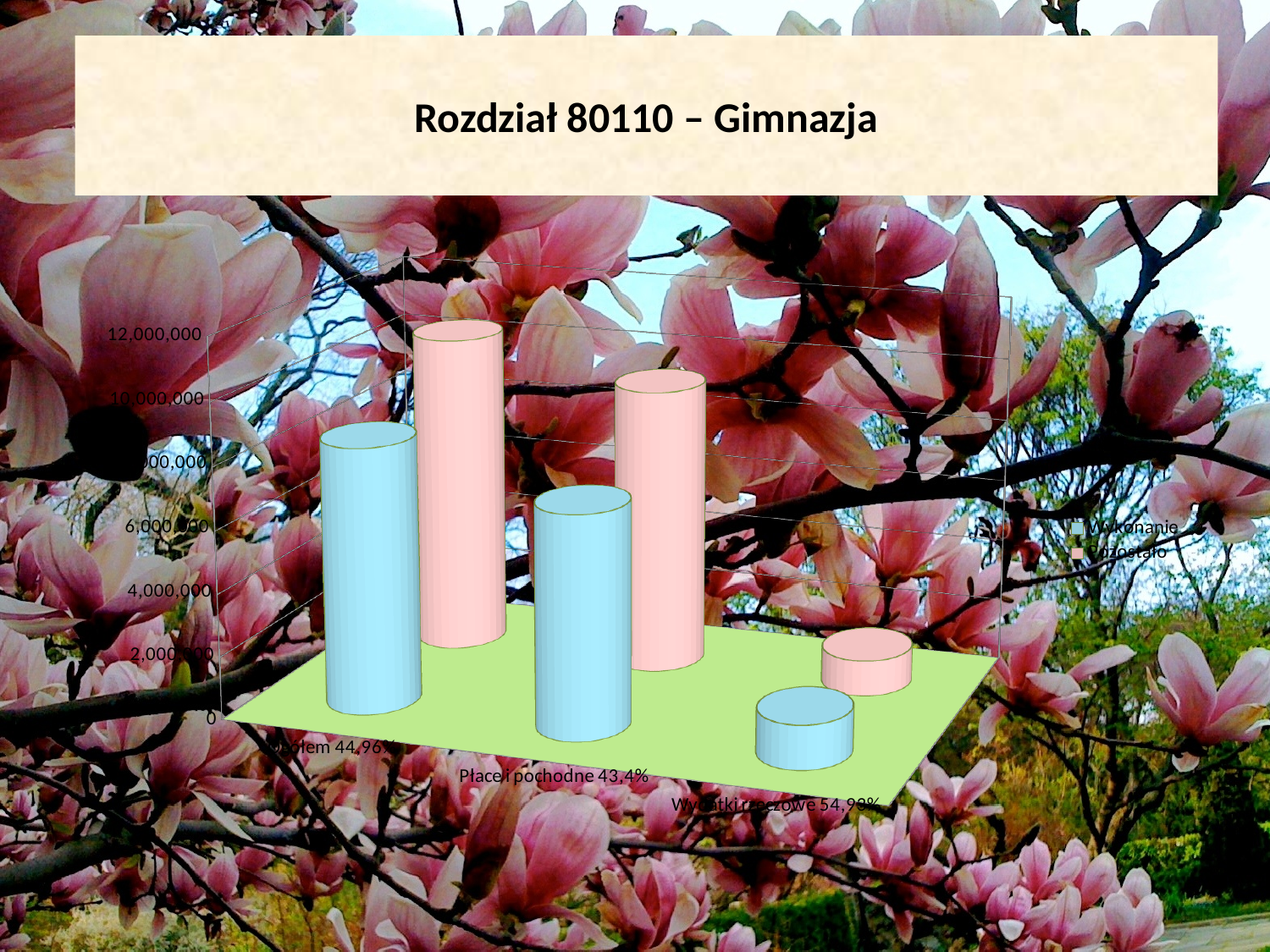
What kind of chart is shown on the slide? bar chart For Ogółem 44,96%, which is larger: Wykonanie or Pozostało? Pozostało Is the Pozostało value for Ogółem 44,96% greater or less than 8,000,000? greater What is the title of the chart? Rozdział 80110 – Gimnazja For Płace i pochodne 43,4%, which is larger: Wykonanie or Pozostało? Pozostało Which category has the highest Wykonanie value? Ogółem 44,96% Which category has the lowest Pozostało value? Wydatki rzeczowe 54,93% What are the two series named in the legend? Wykonanie and Pozostało How many categories are shown on the x axis? 3 How many series does the legend list? 2